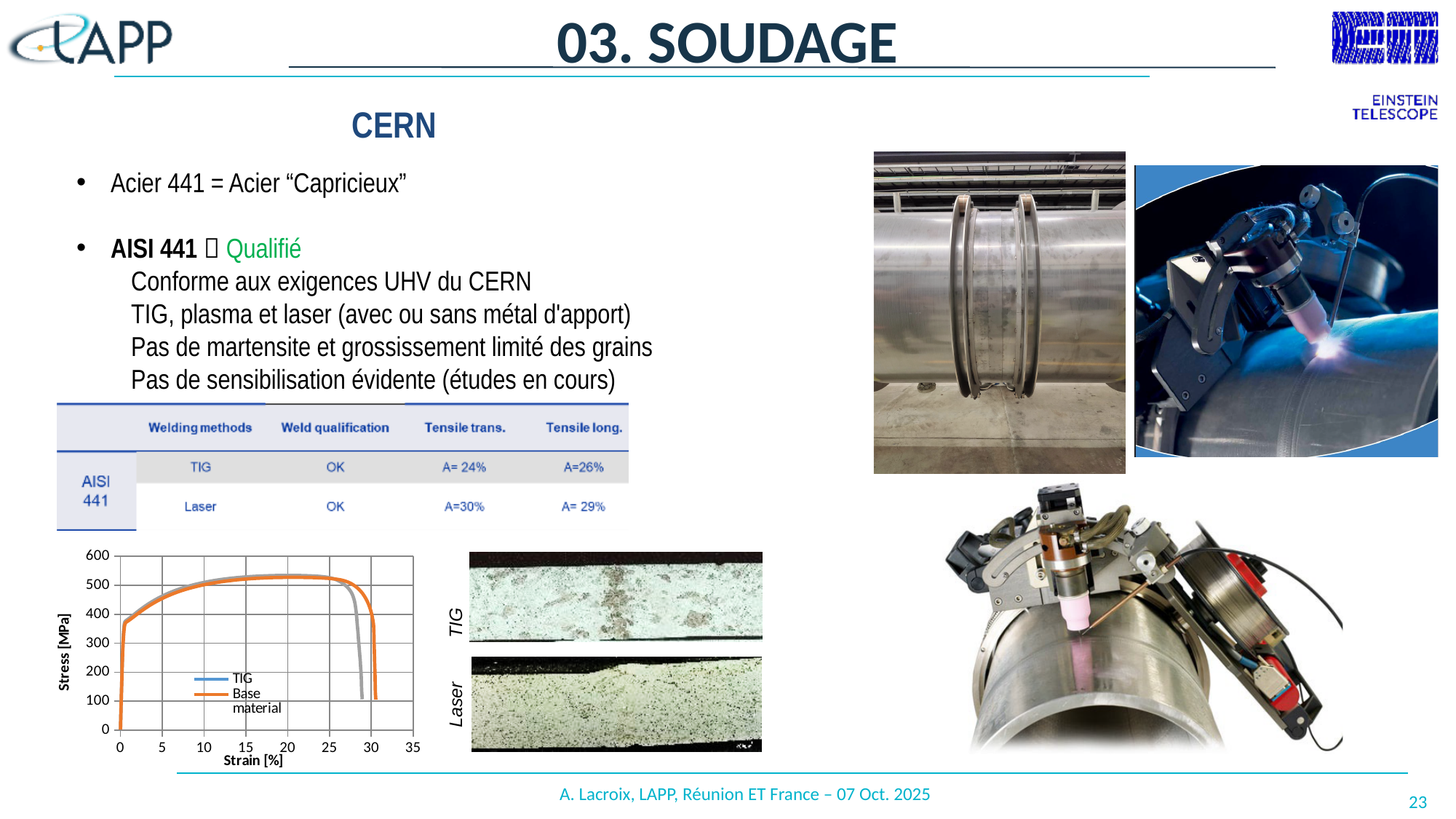
In the stress-strain chart, does the stress rise or fall as strain increases from 28% to 30%? fall What kind of chart is shown at the bottom left of the slide? Line chart In the stress-strain chart, is the maximum stress reached by the Base material curve greater or less than 500? greater In the stress-strain chart, does the stress rise or fall as strain increases from 0 to 15%? rise In the stress-strain chart, is the strain at which the curves end greater or less than 25? greater What are the two series named in the legend of the stress-strain chart? TIG and Base material In the stress-strain chart, is the maximum stress reached by the TIG curve greater or less than 600? less How many series does the legend of the stress-strain chart list? 2 What is the label of the y axis of the stress-strain chart? Stress [MPa]